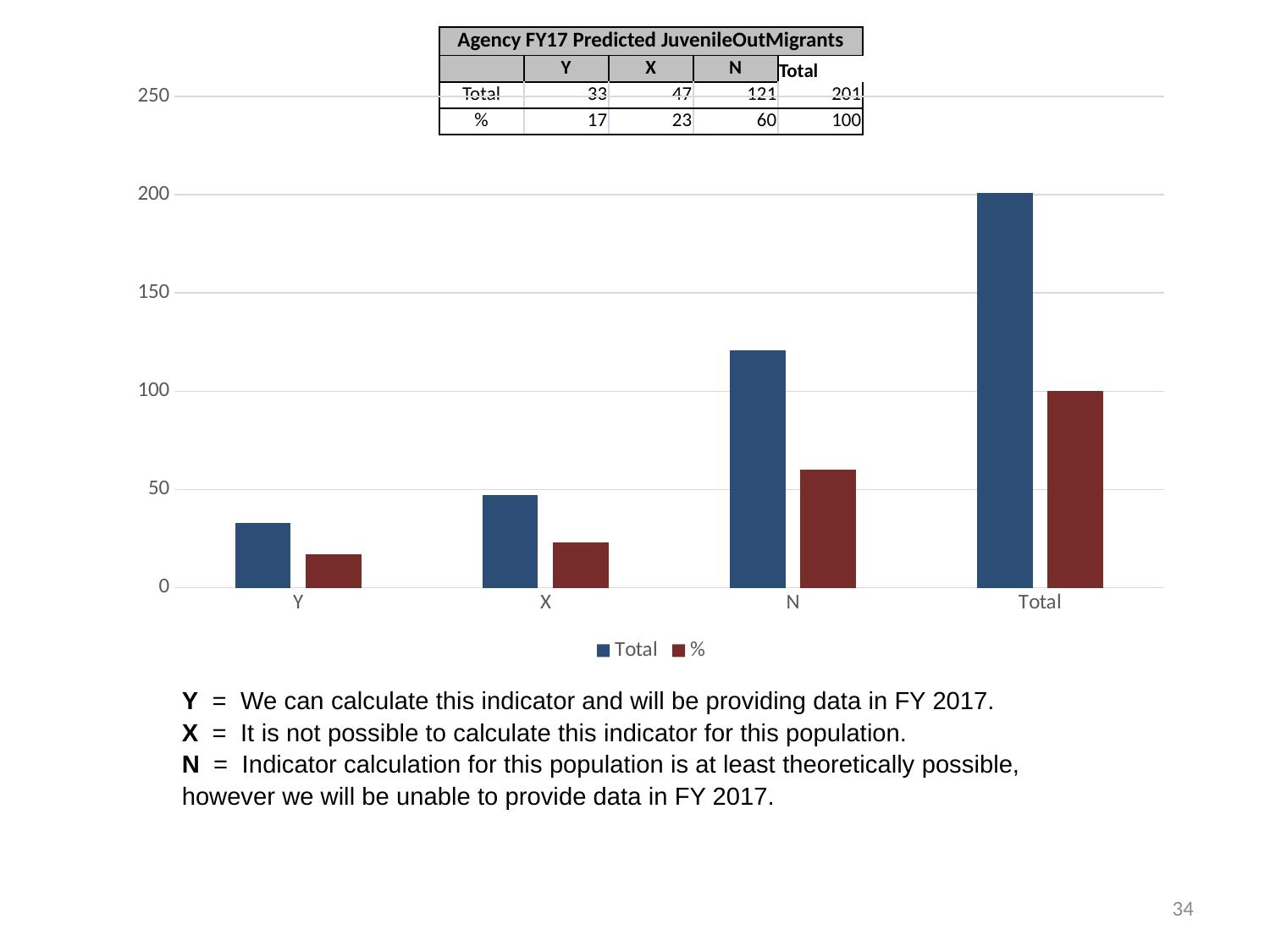
What is the Total value for category N? 121 What is the difference between the Total values for N and X? 74 How many series does the chart legend list? 2 Which is larger, the % value for N or the % value for X? N Among Y, X and N, which category has the highest % value? N Which category has the lowest Total value? Y What is the % value for category X? 23 Is the Total value for the Total category greater or less than 200? greater What kind of chart is shown on the slide? bar chart How many categories are shown on the x axis of the chart? 4 Which series is shown in dark blue in the chart legend? Total What is the Total value for category Y? 33